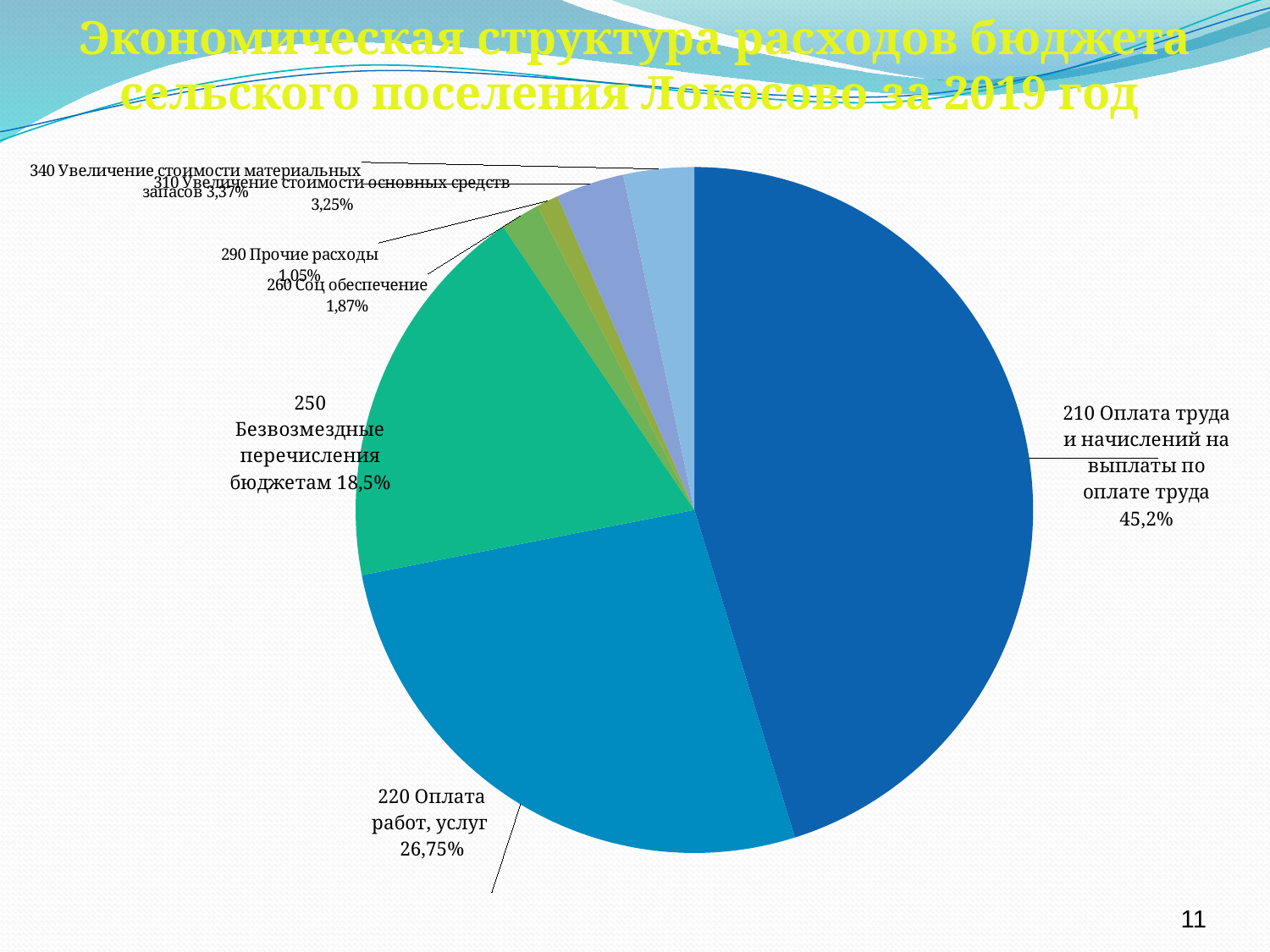
What share of the pie does "210 Оплата труда и начислений на выплаты по оплате труда" have? 45,2% What is the value shown for "260 Соц обеспечение"? 1,87% Which category has the smallest share of the pie? 290 Прочие расходы What kind of chart is shown on the slide? Pie chart What is the value shown for "340 Увеличение стоимости материальных запасов"? 3,37% What is the difference between the shares of "210 Оплата труда и начислений на выплаты по оплате труда" and "220 Оплата работ, услуг"? 18,45% What year does the chart title say the budget expenditure structure refers to? 2019 Which category has the largest share of the pie? 210 Оплата труда и начислений на выплаты по оплате труда What is the value shown for "250 Безвозмездные перечисления бюджетам"? 18,5% What is the value shown for "220 Оплата работ, услуг"? 26,75% Which is larger: the share of "250 Безвозмездные перечисления бюджетам" or "220 Оплата работ, услуг"? 220 Оплата работ, услуг How many slices does the pie chart have? 7